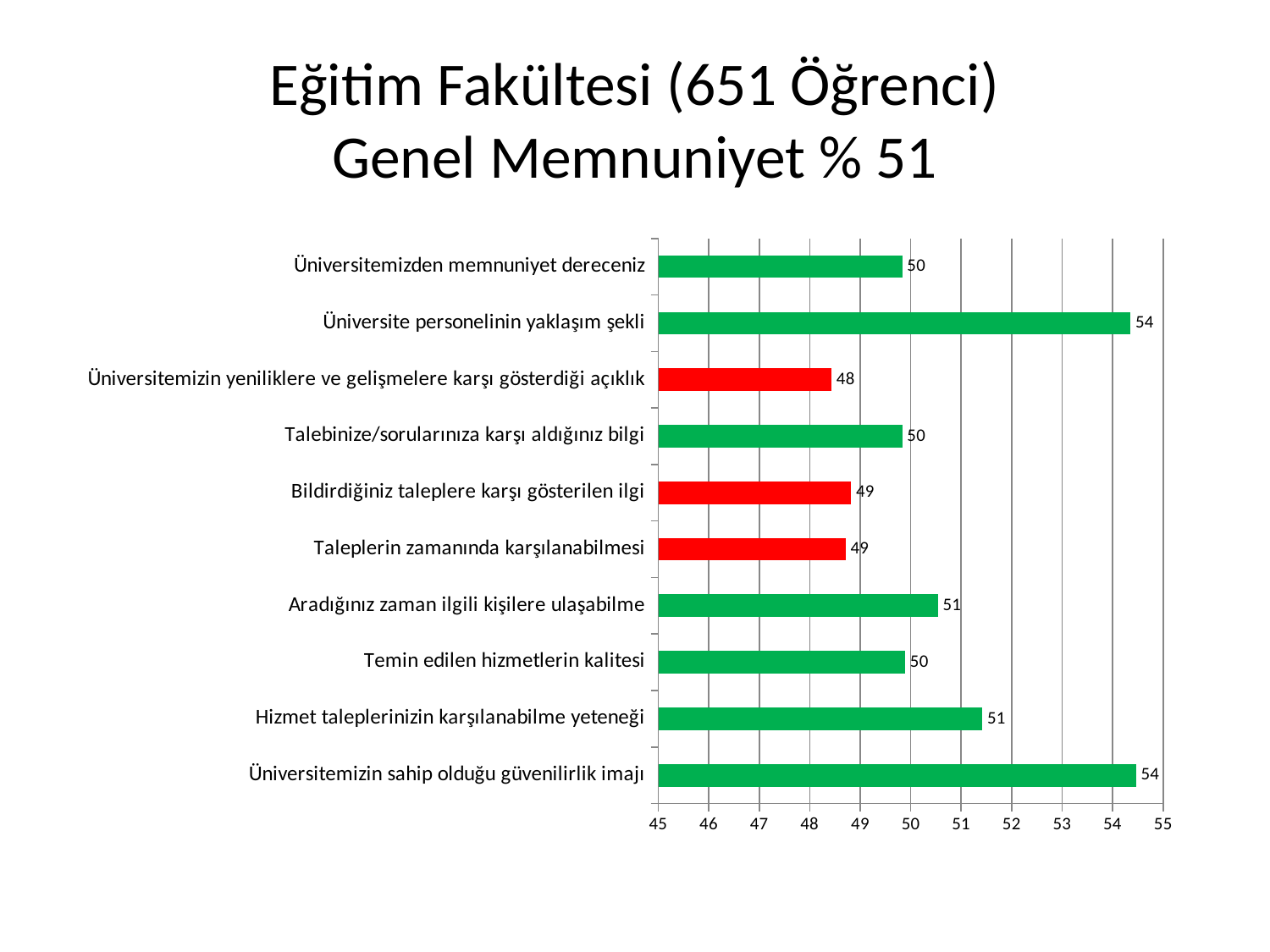
What value is shown for "Üniversitemizden memnuniyet dereceniz"? 50 What value is shown for "Üniversite personelinin yaklaşım şekli"? 54 Which category has the lowest value? Üniversitemizin yeniliklere ve gelişmelere karşı gösterdiği açıklık Which is larger: the value for "Üniversite personelinin yaklaşım şekli" or the value for "Temin edilen hizmetlerin kalitesi"? Üniversite personelinin yaklaşım şekli What is the difference between the value for "Üniversitemizin sahip olduğu güvenilirlik imajı" and the value for "Üniversitemizin yeniliklere ve gelişmelere karşı gösterdiği açıklık"? 6 What value is shown for "Taleplerin zamanında karşılanabilmesi"? 49 Is the value for "Üniversitemizin sahip olduğu güvenilirlik imajı" greater or less than 52? greater What value is shown for "Aradığınız zaman ilgili kişilere ulaşabilme"? 51 What overall satisfaction percentage is stated in the slide title? % 51 What kind of chart is shown on the slide? bar chart How many categories are plotted in the chart? 10 How many bars in the chart are coloured red? 3